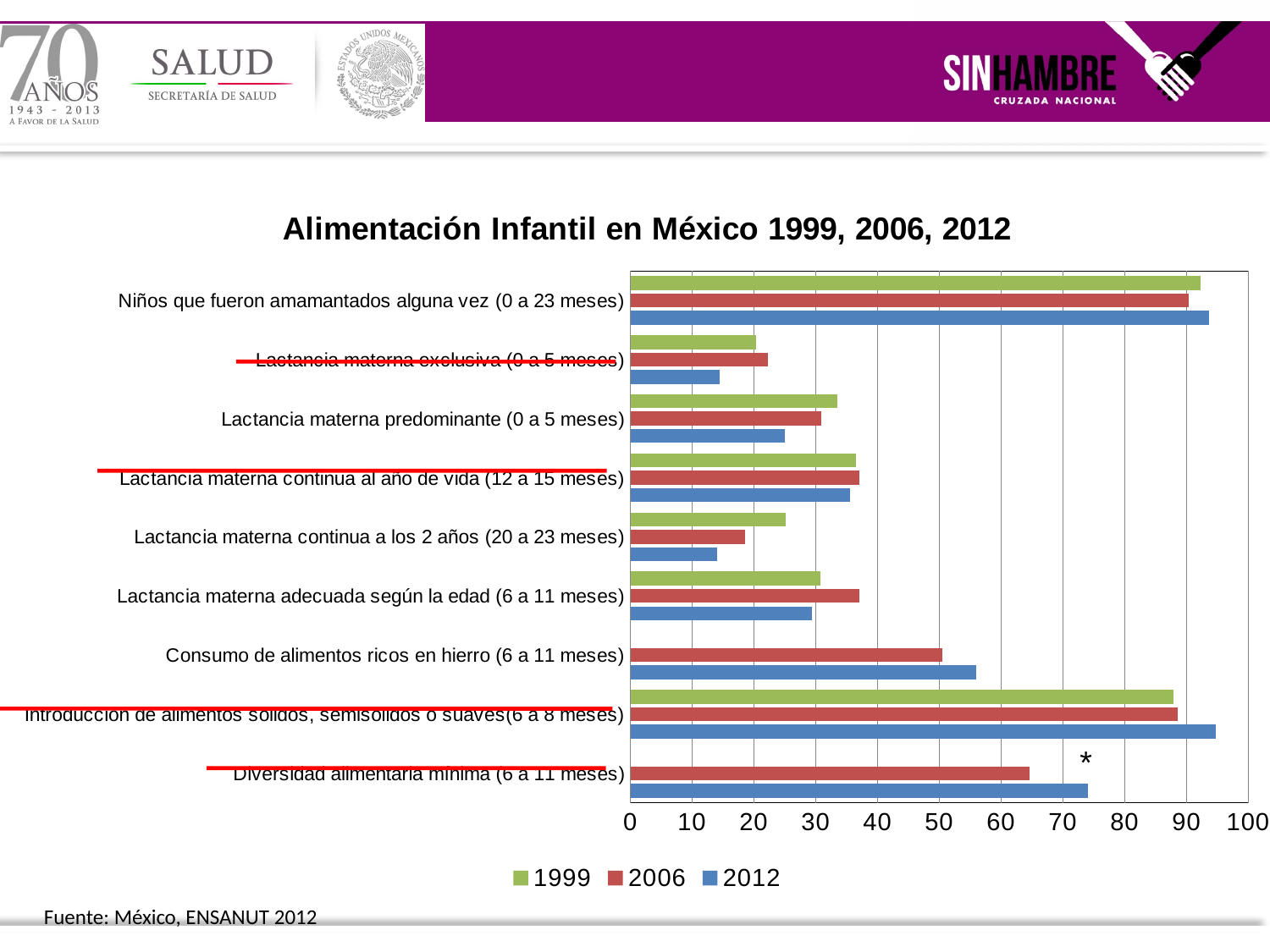
Which years are listed in the chart legend? 1999, 2006, 2012 Is the 2012 value for Consumo de alimentos ricos en hierro (6 a 11 meses) greater or less than 50? greater For Lactancia materna continua a los 2 años (20 a 23 meses), which year has the larger value, 1999 or 2012? 1999 For Lactancia materna adecuada según la edad (6 a 11 meses), which year has the larger value, 1999 or 2006? 2006 Is the 2012 value for Niños que fueron amamantados alguna vez (0 a 23 meses) greater or less than 90? greater For Diversidad alimentaria mínima (6 a 11 meses), which year has the larger value, 2006 or 2012? 2012 Is the 2012 value for Lactancia materna exclusiva (0 a 5 meses) greater or less than 20? less How many categories are shown on the vertical axis of the chart? 9 What is the title of the chart? Alimentación Infantil en México 1999, 2006, 2012 What kind of chart is shown on the slide? bar chart How many series does the legend list? 3